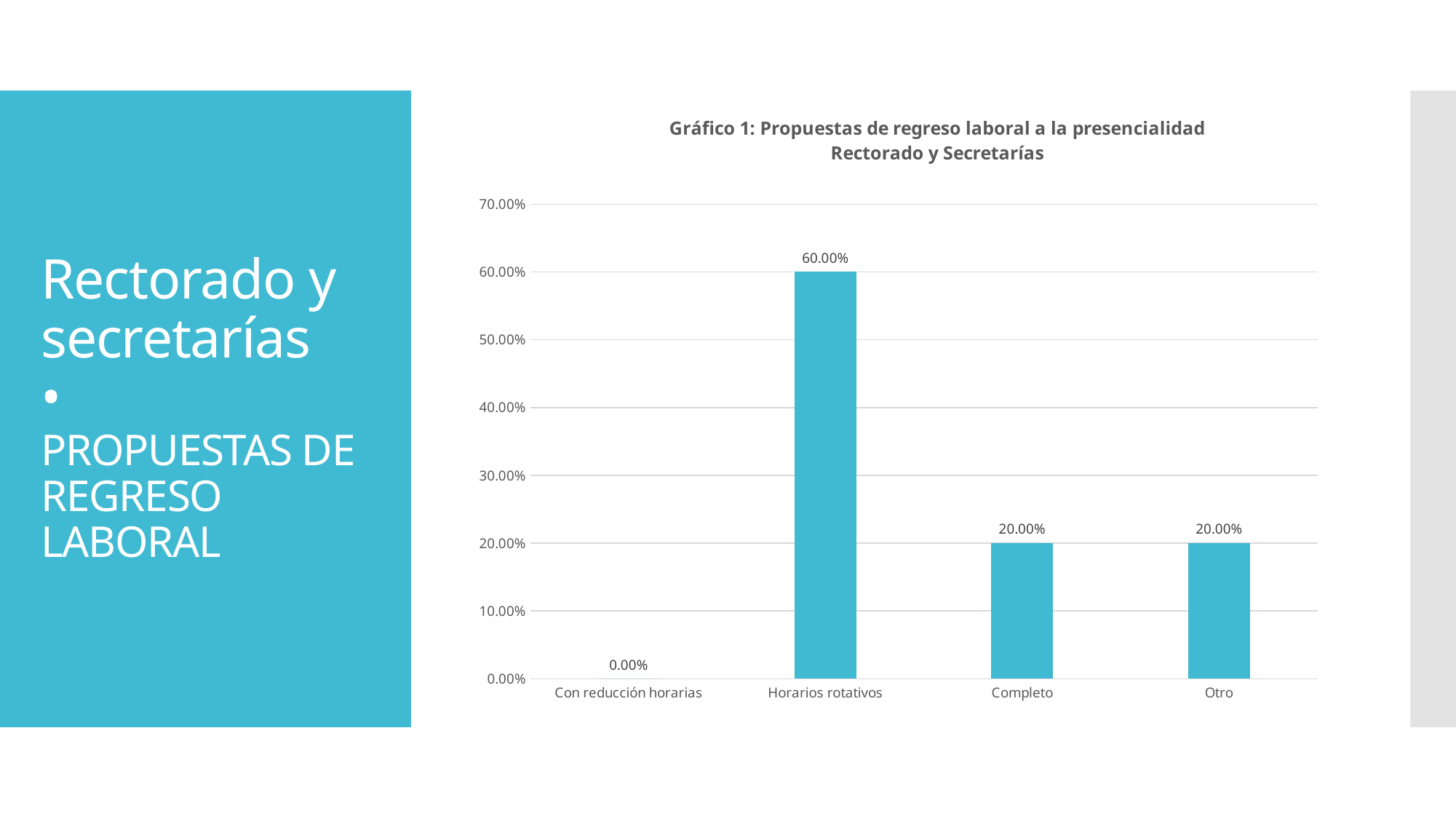
Which category has the lowest value? Con reducción horarias Is the value for Horarios rotativos greater or less than 50.00%? greater How many categories are shown on the x axis? 4 What is the value for Horarios rotativos? 60.00% What is the value for Completo? 20.00% Which category has the highest value? Horarios rotativos What is the title of the chart? Gráfico 1: Propuestas de regreso laboral a la presencialidad Rectorado y Secretarías Which is larger, the value for Horarios rotativos or the value for Otro? Horarios rotativos What is the difference between the values for Horarios rotativos and Completo? 40.00% What is the value for Con reducción horarias? 0.00% What kind of chart is shown on the slide? bar chart What is the value for Otro? 20.00%